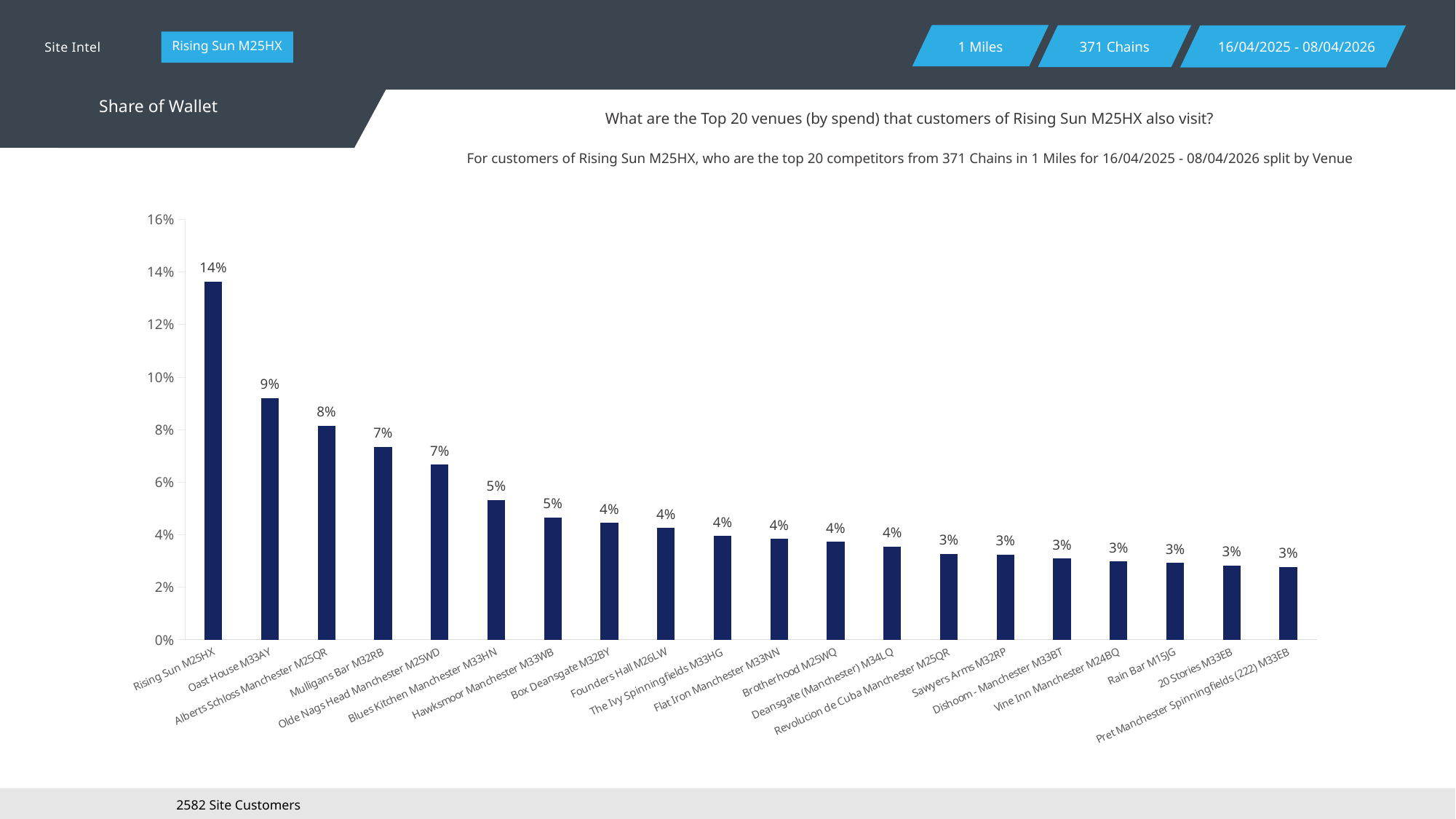
What kind of chart is shown on the slide? bar chart What is the value for Alberts Schloss Manchester M25QR? 8% How many venues are shown in the chart? 20 Which venue has the highest value? Rising Sun M25HX What is the value for Rain Bar M15JG? 3% What is the value for Hawksmoor Manchester M33WB? 5% Do the values rise or fall from left to right along the x axis? fall What is the value for Rising Sun M25HX? 14% What is the value for Oast House M33AY? 9% What is the difference between the values for Rising Sun M25HX and Oast House M33AY? 5% Is the value for Rising Sun M25HX greater or less than 12%? greater Which is larger, the value for Oast House M33AY or Alberts Schloss Manchester M25QR? Oast House M33AY